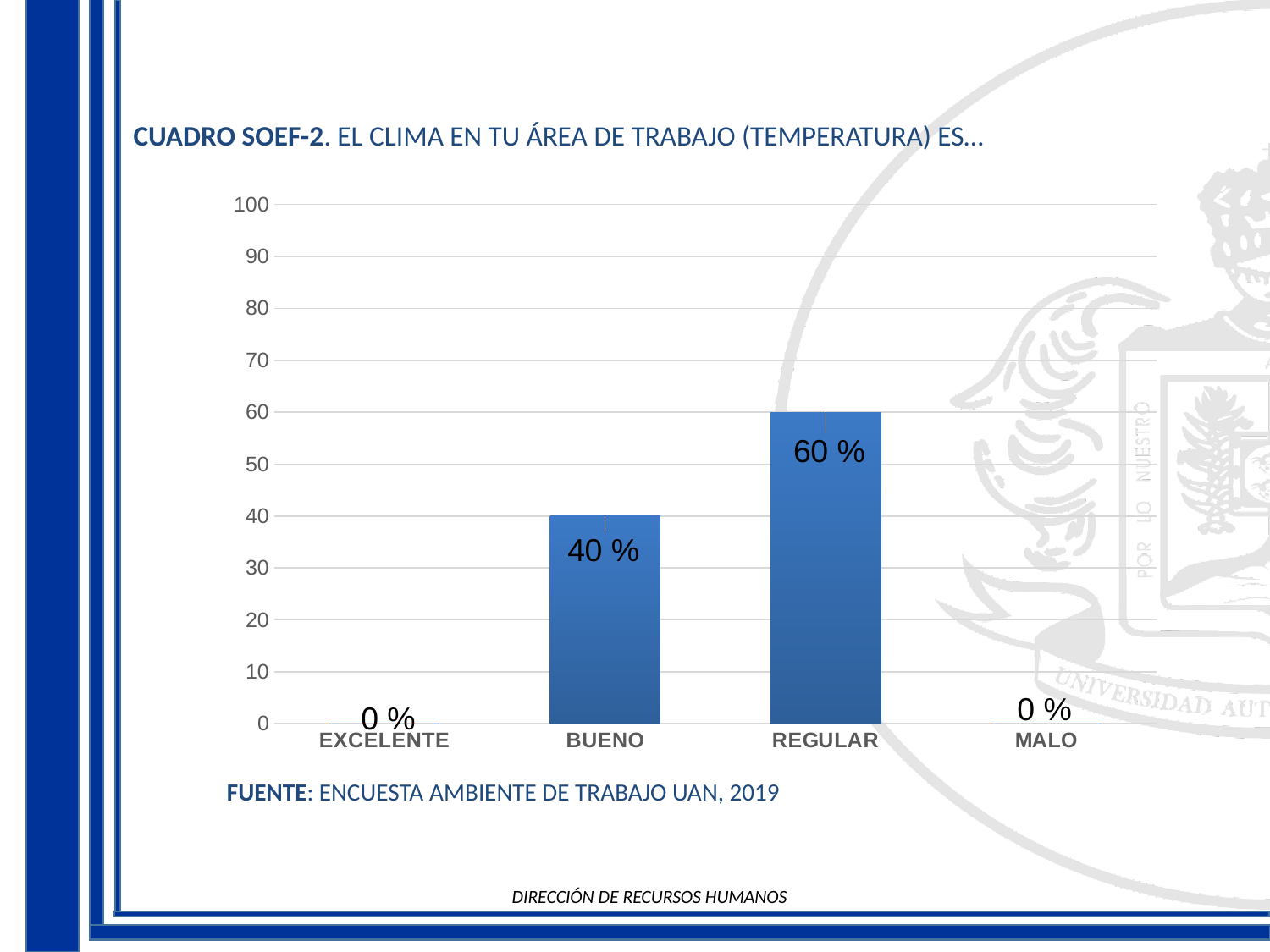
What is the value for BUENO? 40 % What kind of chart is shown on the slide? bar chart Is the value for REGULAR greater or less than 50? greater Which is larger, the value for BUENO or the value for REGULAR? REGULAR What is the value for EXCELENTE? 0 % What is the value for MALO? 0 % Which category has the highest value? REGULAR What is the source cited below the chart? ENCUESTA AMBIENTE DE TRABAJO UAN, 2019 What is the title of the chart? CUADRO SOEF-2. EL CLIMA EN TU ÁREA DE TRABAJO (TEMPERATURA) ES… How many categories are shown on the x axis? 4 What is the difference between the values for REGULAR and BUENO? 20 % What is the value for REGULAR? 60 %